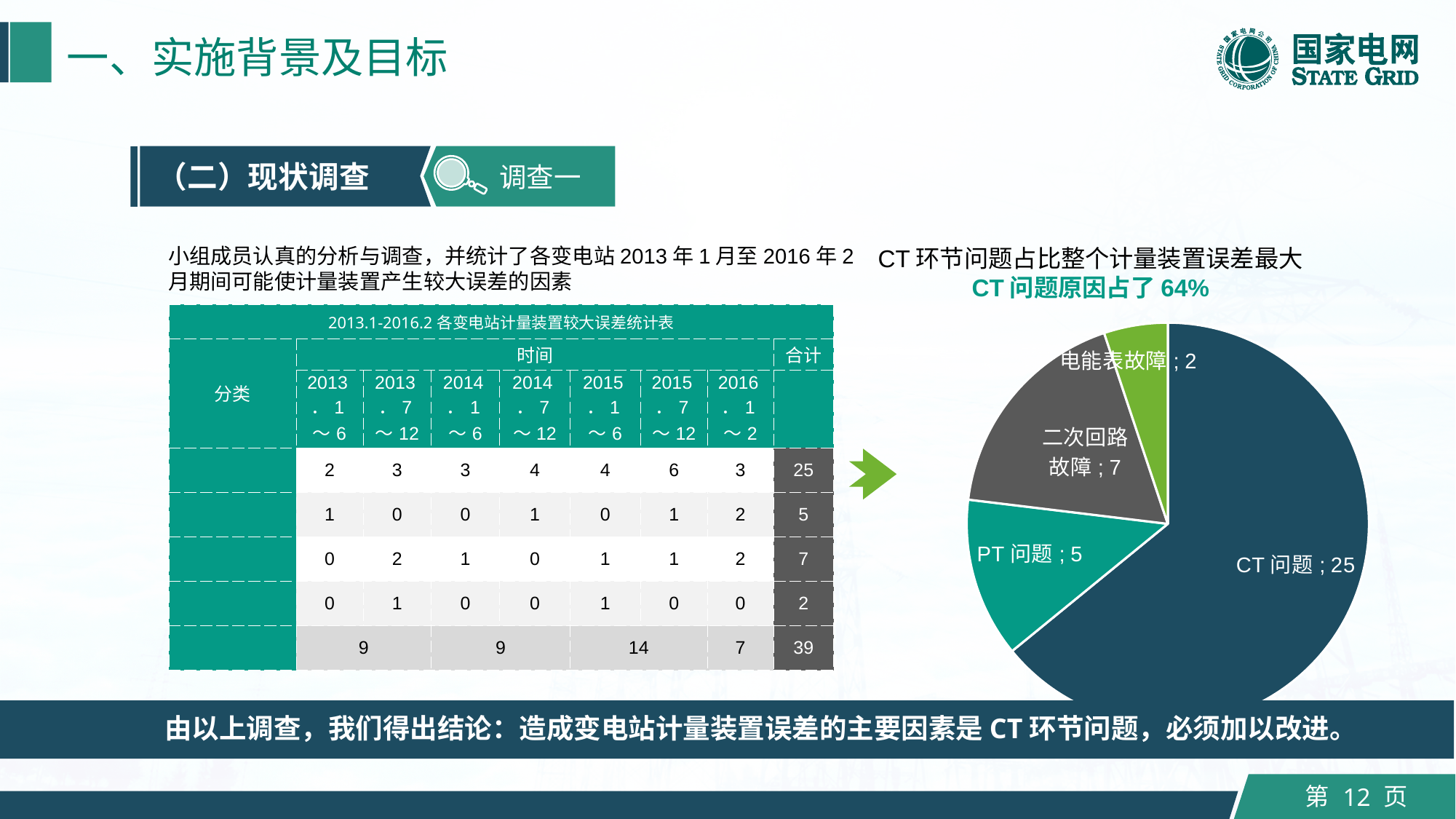
In the pie chart, what is the value for 电能表故障? 2 How many slices does the pie chart have? 4 In the pie chart, what is the value for 二次回路故障? 7 Which category has the largest slice in the pie chart? CT 问题 In the pie chart, what is the difference between the values for CT 问题 and 二次回路故障? 18 In the pie chart, what is the value for PT 问题? 5 In the pie chart, which is larger: 二次回路故障 or PT 问题? 二次回路故障 In the pie chart, what is the value for CT 问题? 25 Which category has the smallest slice in the pie chart? 电能表故障 What is the total of all the values shown in the pie chart? 39 What kind of chart is shown on the right side of the slide? pie chart What share of the pie chart does CT 问题 account for? 64%